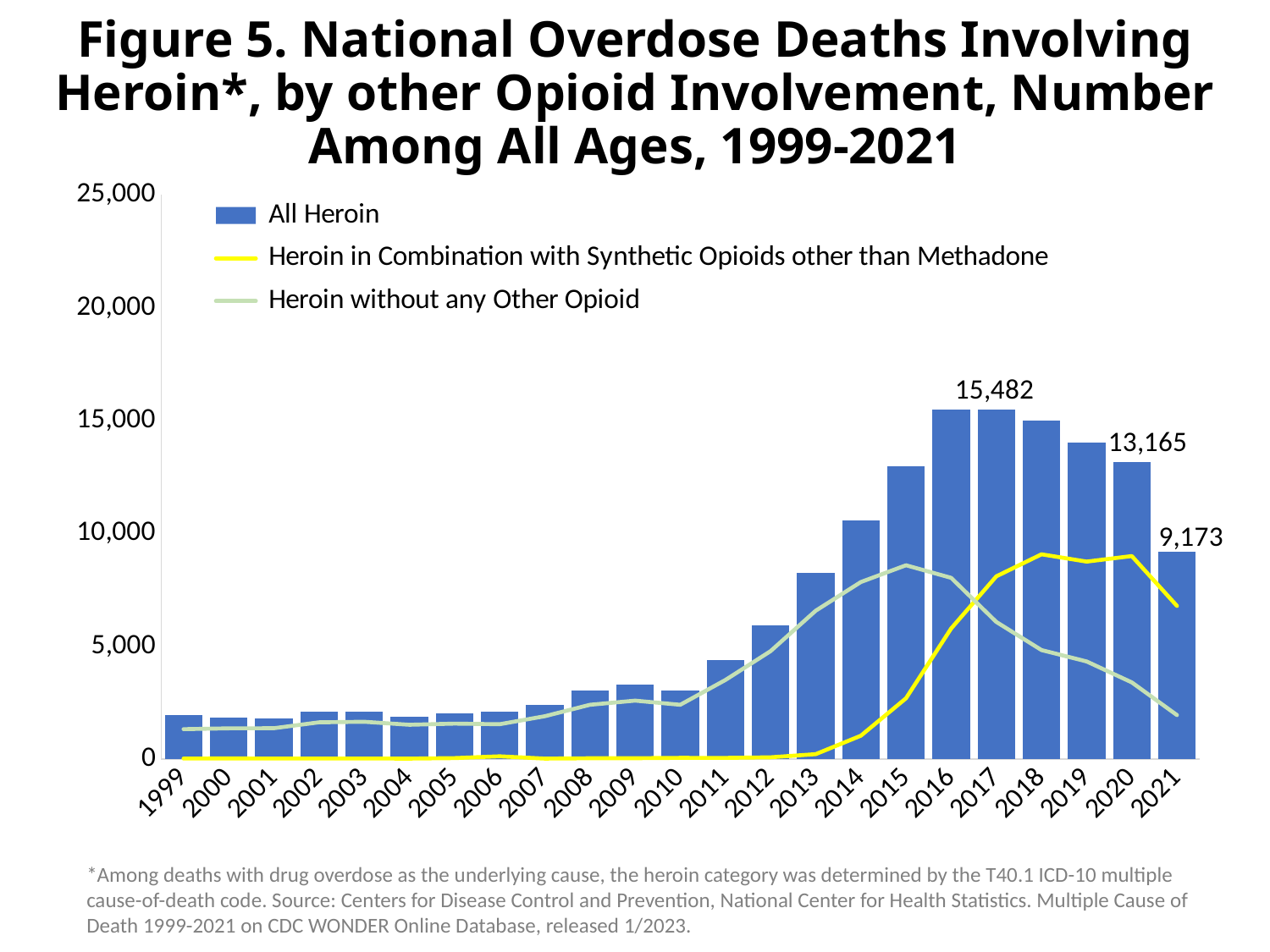
What is the All Heroin value for 2017? 15,482 What is the difference between the All Heroin values for 2020 and 2021? 3,992 Which is larger, the All Heroin value for 2020 or for 2021? 2020 How many years are shown on the x axis? 23 What is the All Heroin value for 2020? 13,165 Is the All Heroin value for 2015 greater or less than 10,000? greater In 2021, which line is higher: Heroin in Combination with Synthetic Opioids other than Methadone or Heroin without any Other Opioid? Heroin in Combination with Synthetic Opioids other than Methadone How many series does the legend list? 3 Is the All Heroin value for 2012 greater or less than 10,000? less What is the All Heroin value for 2021? 9,173 What kind of chart is shown on the slide? bar chart with two line series What is the difference between the All Heroin values for 2017 and 2021? 6,309